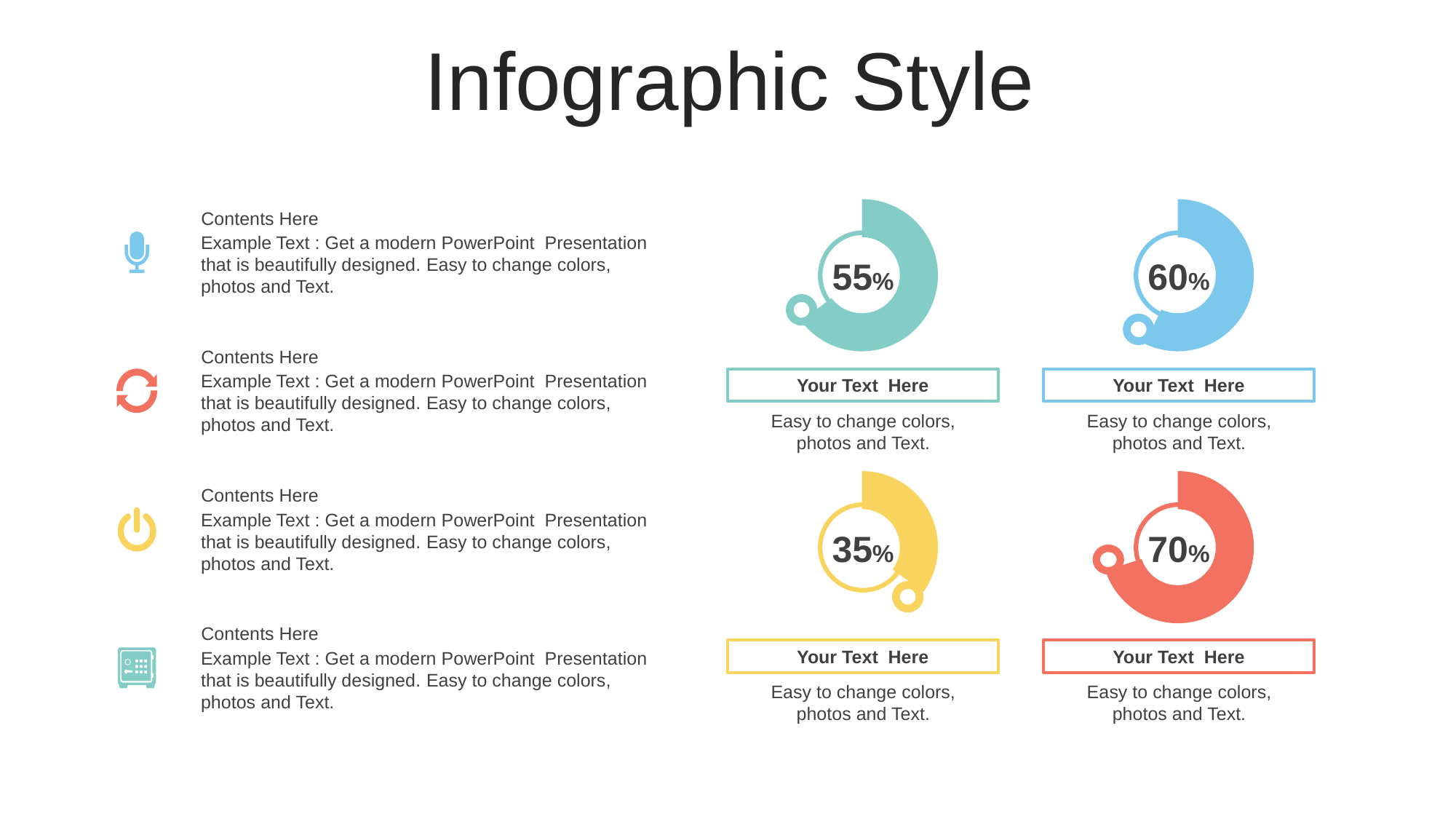
What value is shown in the teal ring chart at the top left of the chart area? 55% What value is shown in the red ring chart at the bottom right? 70% What colour is the ring chart that shows 60%? Blue How many ring charts are shown on the slide? 4 What is the difference between the value in the blue ring chart and the value in the teal ring chart? 5% What value is shown in the yellow ring chart at the bottom left? 35% What value is shown in the blue ring chart at the top right? 60% What kind of chart is used to display the percentages on the right side of the slide? Ring (donut) chart What is the difference between the value in the red ring chart and the value in the yellow ring chart? 35% Which of the four ring charts shows the highest percentage? The red chart (70%) Which is larger, the value in the teal ring chart or the value in the yellow ring chart? The teal ring chart (55%) Which of the four ring charts shows the lowest percentage? The yellow chart (35%)